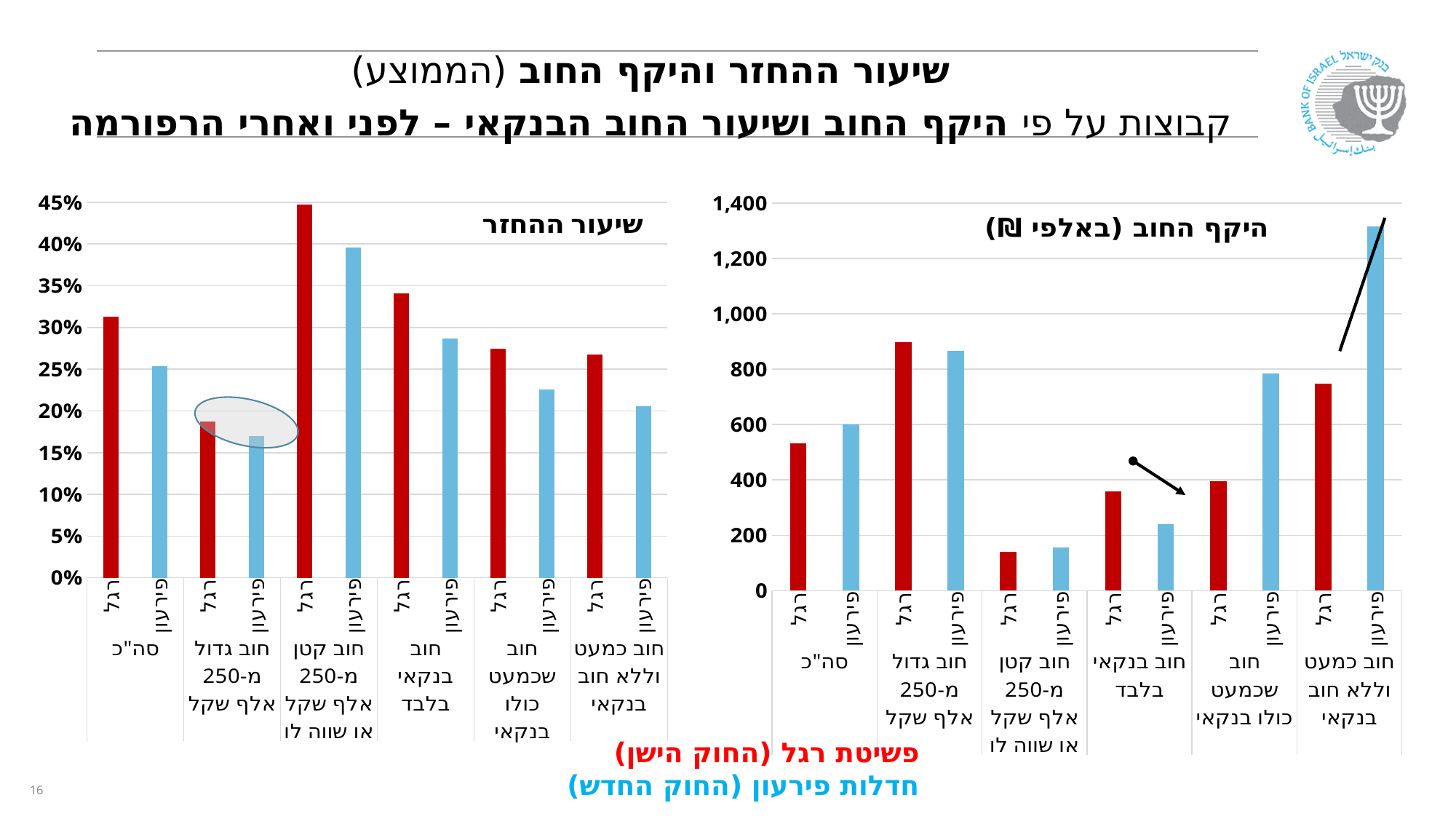
In the right chart titled היקף החוב (באלפי ₪), which is larger for חוב שכמעט כולו בנקאי: the רגל bar or the פירעון bar? פירעון What kind of chart is the left chart titled שיעור ההחזר? bar chart In the left chart titled שיעור ההחזר, which bar is the highest? רגל for חוב קטן מ-250 אלף שקל או שווה לו In the left chart titled שיעור ההחזר, is the רגל value for סה"כ greater or less than 30%? greater In the right chart titled היקף החוב (באלפי ₪), which bar is the lowest? רגל for חוב קטן מ-250 אלף שקל או שווה לו In the right chart titled היקף החוב (באלפי ₪), is the פירעון value for חוב כמעט וללא חוב בנקאי greater or less than 1,200? greater What colour are the פירעון bars in both charts? blue In the right chart titled היקף החוב (באלפי ₪), is the רגל value for חוב בנקאי בלבד greater or less than 400? less In the right chart titled היקף החוב (באלפי ₪), which bar is the highest? פירעון for חוב כמעט וללא חוב בנקאי In the left chart titled שיעור ההחזר, which is larger for חוב בנקאי בלבד: the רגל bar or the פירעון bar? רגל In the right chart titled היקף החוב (באלפי ₪), how many category groups are shown on the x axis? 6